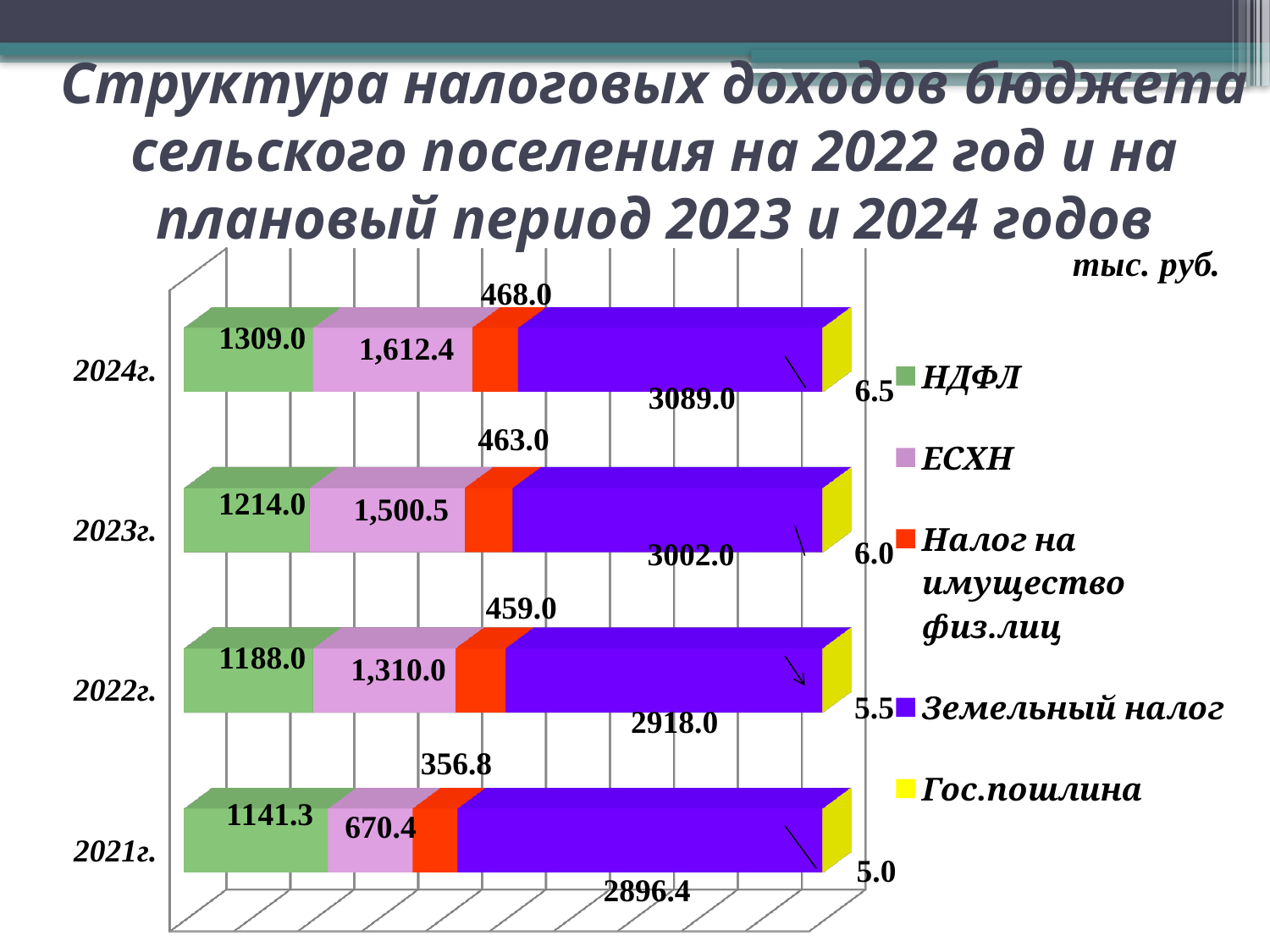
In which year is the value of НДФЛ the highest? 2024г. What is the value of Налог на имущество физ.лиц for 2021г.? 356.8 How many series does the legend list? 5 What is the value of ЕСХН for 2021г.? 670.4 Which is larger for 2023г.: ЕСХН or НДФЛ? ЕСХН What is the total of the stacked bar for 2021г.? 5069.9 What is the difference between Земельный налог in 2024г. and in 2021г.? 192.6 What is the value of НДФЛ for 2024г.? 1309.0 How many years are shown on the chart? 4 What is the value of Гос.пошлина for 2022г.? 5.5 In which year is the value of ЕСХН the lowest? 2021г. What is the value of Земельный налог for 2023г.? 3002.0